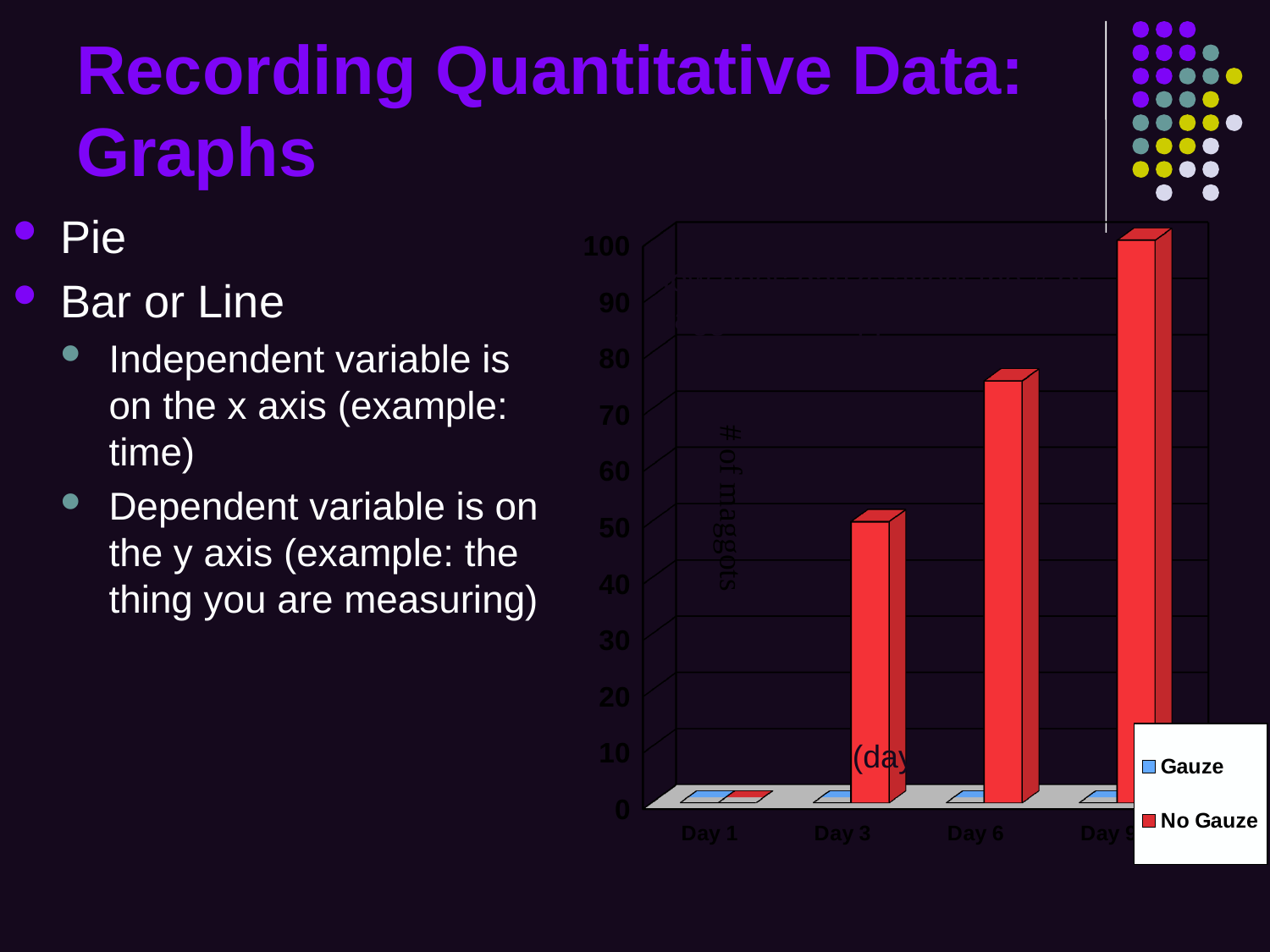
Is the No Gauze value for Day 6 greater or less than 80? less Which day has the highest No Gauze value? Day 9 What kind of chart is shown on the slide? bar chart Which is larger, the No Gauze value for Day 3 or for Day 6? Day 6 What colour are the No Gauze bars in the chart? red Which day has the lowest No Gauze value? Day 1 How many categories are shown on the x axis of the chart? 4 Do the No Gauze values rise or fall from Day 1 to Day 9? rise Is the No Gauze value for Day 6 greater or less than 70? greater Is the No Gauze value for Day 9 greater or less than 90? greater How many series does the chart's legend list? 2